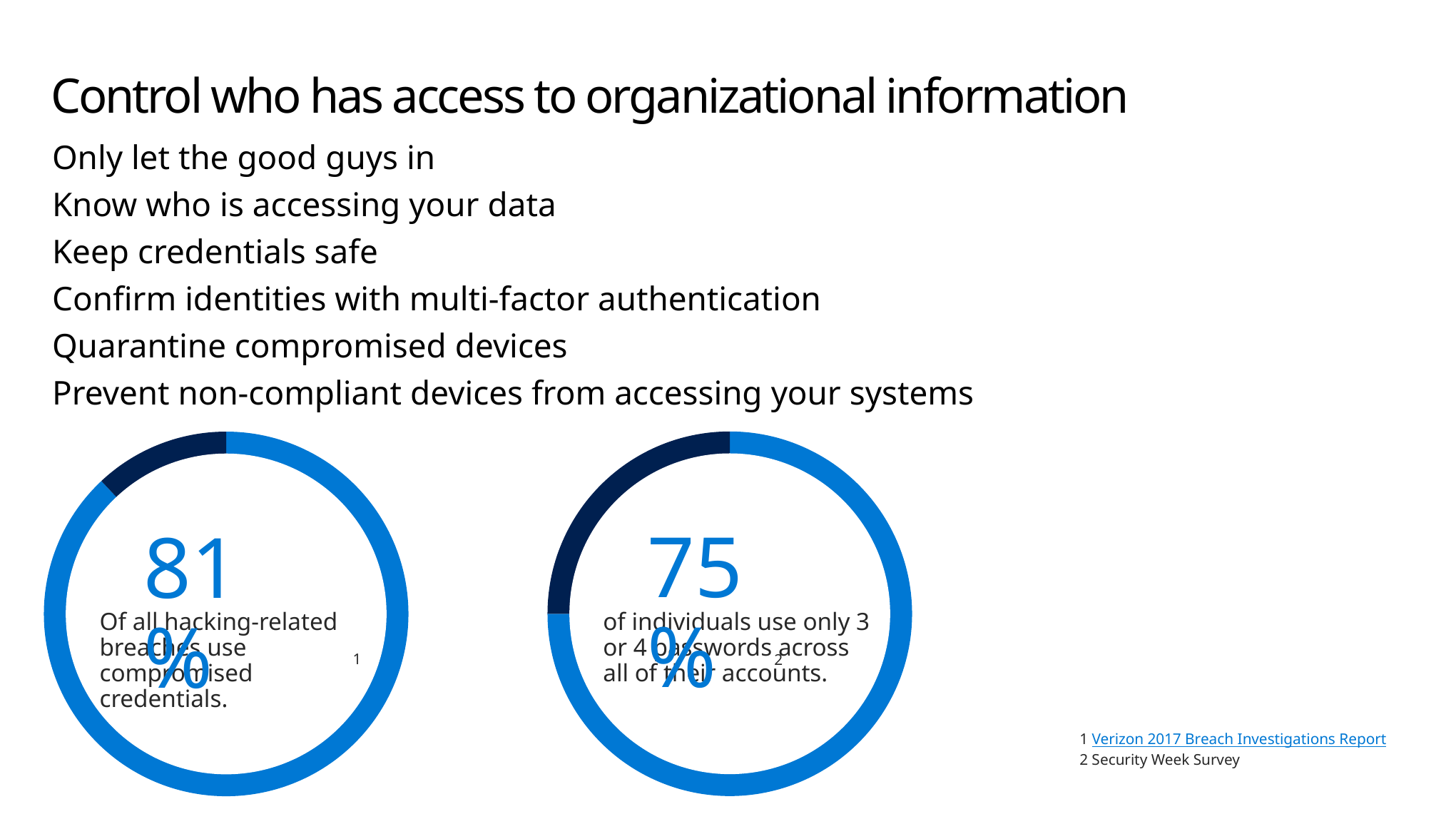
What kind of chart is the right chart on the slide? Doughnut chart According to the footnote, what is the source for the left chart's 81% statistic? Verizon 2017 Breach Investigations Report How many segments does the right chart's ring have? 2 In the right chart, is the light blue segment or the dark navy segment larger? The light blue segment How many segments does the left chart's ring have? 2 Which chart shows the larger highlighted percentage, the left chart (81%) or the right chart (75%)? The left chart How many doughnut charts are shown on the slide? 2 What kind of chart is the left chart on the slide? Doughnut chart In the left chart, is the light blue segment or the dark navy segment larger? The light blue segment In the left chart, what percentage of all hacking-related breaches use compromised credentials? 81% Which colour represents the 81% share in the left chart? Light blue In the right chart, what percentage of individuals use only 3 or 4 passwords across all of their accounts? 75%